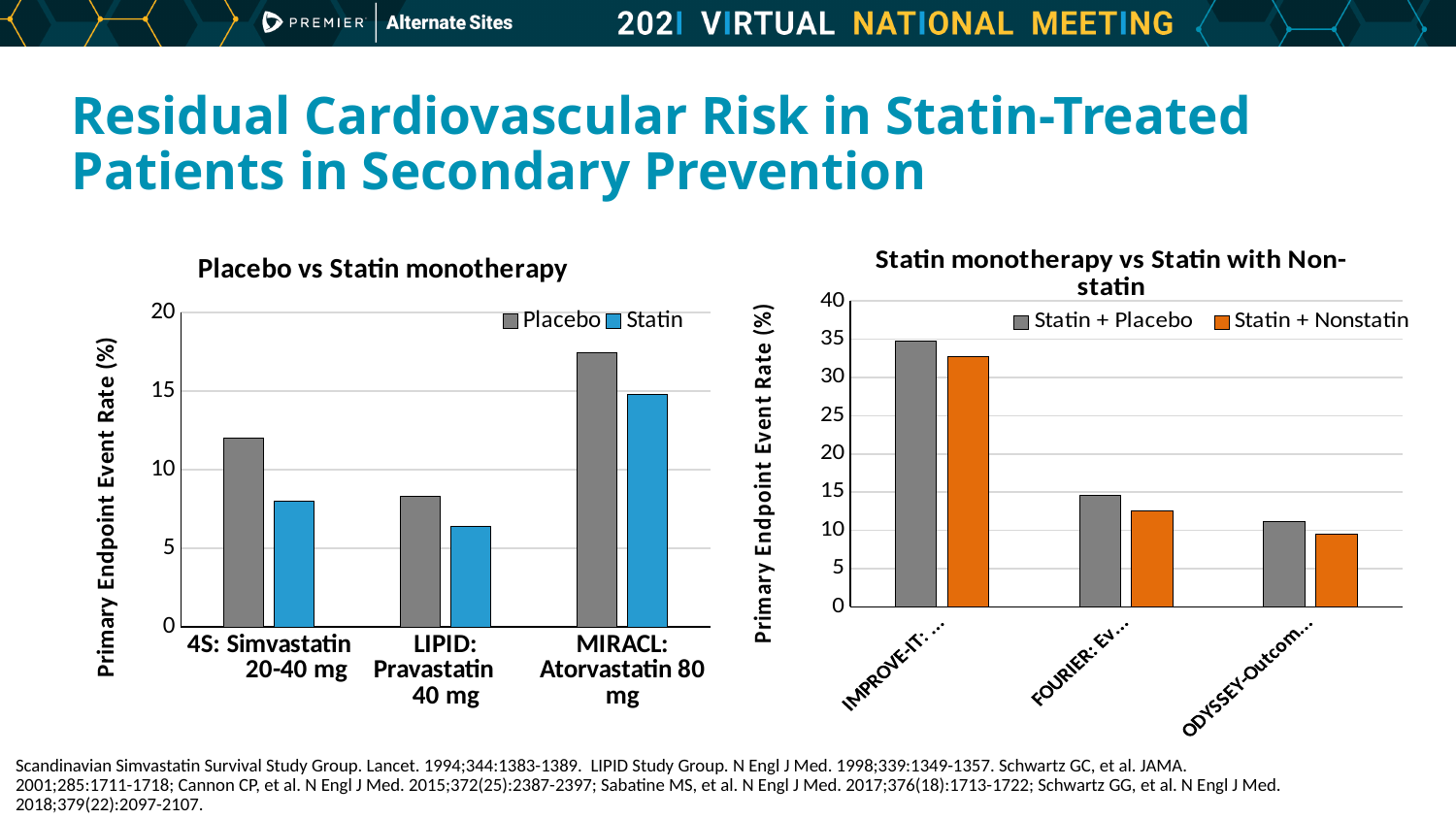
In the left chart ('Placebo vs Statin monotherapy'), is the Placebo value for 4S: Simvastatin 20-40 mg greater or less than 10? greater How many series does the legend of the right chart ('Statin monotherapy vs Statin with Non-statin') list? 2 In the right chart ('Statin monotherapy vs Statin with Non-statin'), do the Statin + Placebo values rise or fall from IMPROVE-IT to ODYSSEY? Fall How many trial categories are shown on the x axis of the left chart ('Placebo vs Statin monotherapy')? 3 What kind of chart is the 'Placebo vs Statin monotherapy' chart on the left? Bar chart In the right chart ('Statin monotherapy vs Statin with Non-statin'), which trial has the highest Statin + Placebo event rate? IMPROVE-IT How many series does the legend of the left chart ('Placebo vs Statin monotherapy') list? 2 In the left chart ('Placebo vs Statin monotherapy'), which trial has the lowest Statin event rate? LIPID: Pravastatin 40 mg In the left chart ('Placebo vs Statin monotherapy'), which trial has the highest Placebo event rate? MIRACL: Atorvastatin 80 mg In the right chart ('Statin monotherapy vs Statin with Non-statin'), is the Statin + Nonstatin value for FOURIER greater or less than 15? less In the left chart ('Placebo vs Statin monotherapy'), which is larger for LIPID: Pravastatin 40 mg, the Placebo bar or the Statin bar? Placebo